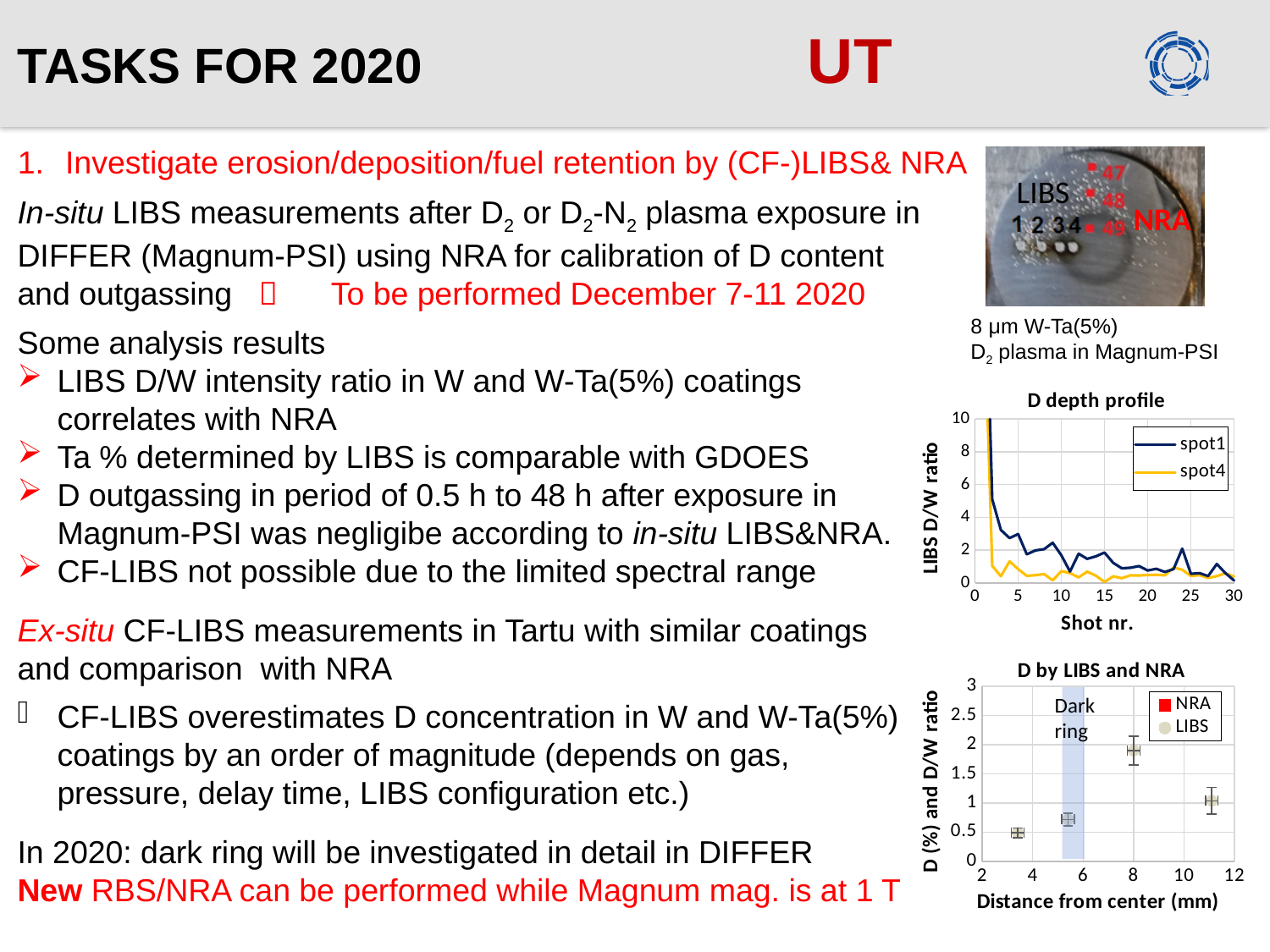
How many series does the legend of the 'D depth profile' chart list? 2 In the 'D depth profile' chart, do the LIBS D/W ratio values for spot1 rise or fall as the shot number increases? fall How many series does the legend of the 'D by LIBS and NRA' chart list? 2 In the 'D depth profile' chart, what are the two series named in the legend? spot1 and spot4 In the 'D depth profile' chart, is the LIBS D/W ratio for spot1 at shot nr. 5 greater or less than 2? greater What is the x-axis title of the 'D depth profile' chart? Shot nr. What kind of chart is the 'D depth profile' chart? line chart In the 'D by LIBS and NRA' chart, is the value at 8 mm from center greater or less than 1.5? greater In the 'D by LIBS and NRA' chart, is the value at about 3 mm from center greater or less than 1? less In the 'D by LIBS and NRA' chart, at which distance from center is the plotted value highest? 8 mm In the 'D depth profile' chart, which series has the larger LIBS D/W ratio at shot nr. 5, spot1 or spot4? spot1